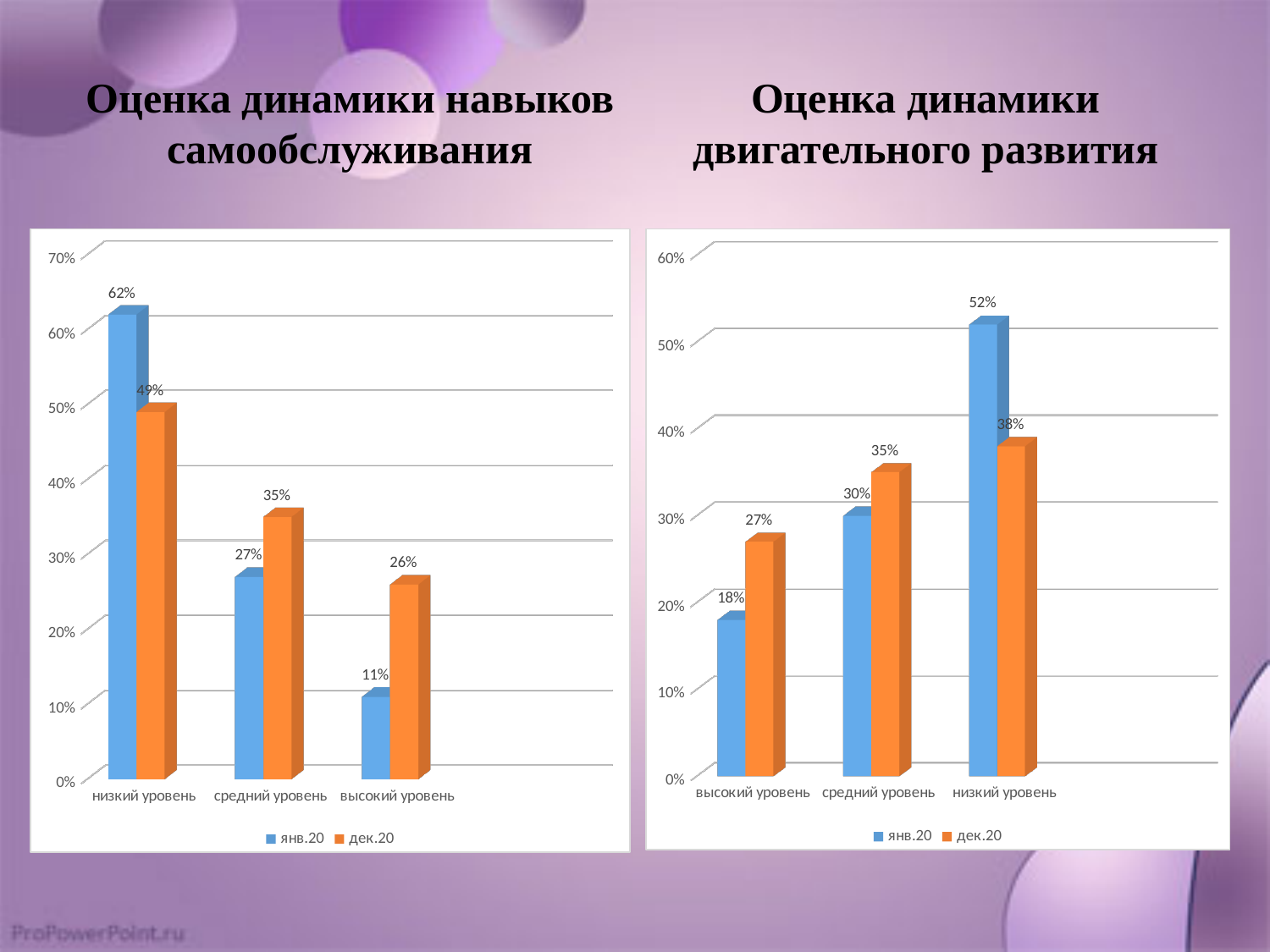
In the right chart (Оценка динамики двигательного развития), what is the value for средний уровень in дек.20? 35% In the right chart (Оценка динамики двигательного развития), how many categories are shown on the x axis? 3 In the left chart (Оценка динамики навыков самообслуживания), what is the value for высокий уровень in дек.20? 26% In the left chart (Оценка динамики навыков самообслуживания), what is the difference between the янв.20 and дек.20 values for низкий уровень? 13% What kind of chart is the right chart (Оценка динамики двигательного развития)? bar chart In the right chart (Оценка динамики двигательного развития), what is the difference between the янв.20 and дек.20 values for низкий уровень? 14% In the right chart (Оценка динамики двигательного развития), which category has the highest value in янв.20? низкий уровень In the left chart (Оценка динамики навыков самообслуживания), which category has the lowest value in янв.20? высокий уровень In the left chart (Оценка динамики навыков самообслуживания), which is larger for средний уровень: янв.20 or дек.20? дек.20 In the left chart (Оценка динамики навыков самообслуживания), how many series does the legend list? 2 In the right chart (Оценка динамики двигательного развития), what is the value for высокий уровень in янв.20? 18% In the left chart (Оценка динамики навыков самообслуживания), what is the value for низкий уровень in янв.20? 62%